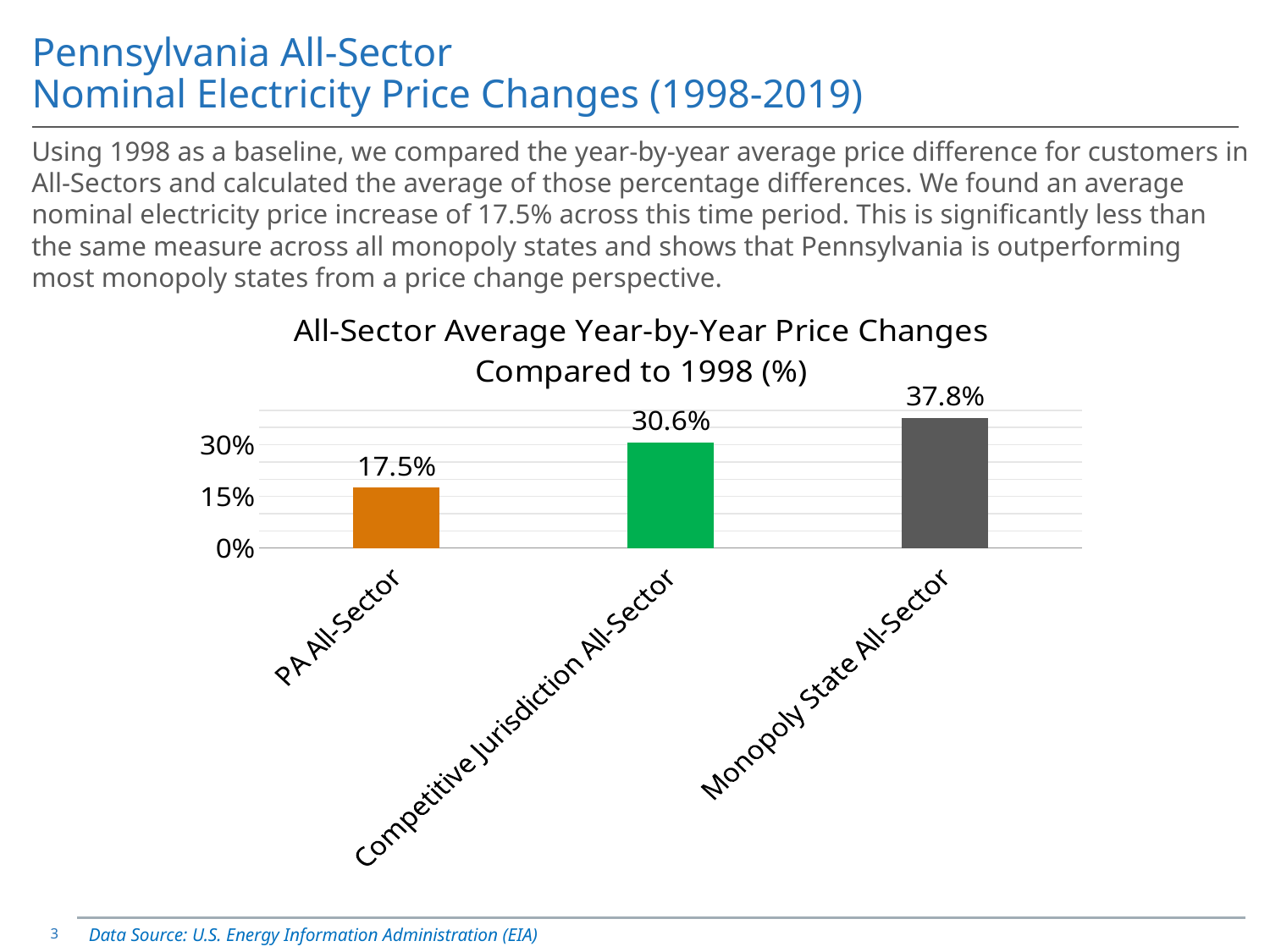
What is the difference between the Competitive Jurisdiction All-Sector and PA All-Sector values? 13.1% Which category has the highest value? Monopoly State All-Sector What is the value for PA All-Sector? 17.5% What is the value for Monopoly State All-Sector? 37.8% What kind of chart is shown on the slide? bar chart What is the value for Competitive Jurisdiction All-Sector? 30.6% How many categories are shown in the chart? 3 Which category has the lowest value? PA All-Sector What is the difference between the Monopoly State All-Sector and PA All-Sector values? 20.3% Which is larger, the value for Competitive Jurisdiction All-Sector or Monopoly State All-Sector? Monopoly State All-Sector What is the title of the chart? All-Sector Average Year-by-Year Price Changes Compared to 1998 (%) Is the value for PA All-Sector greater or less than 30%? less